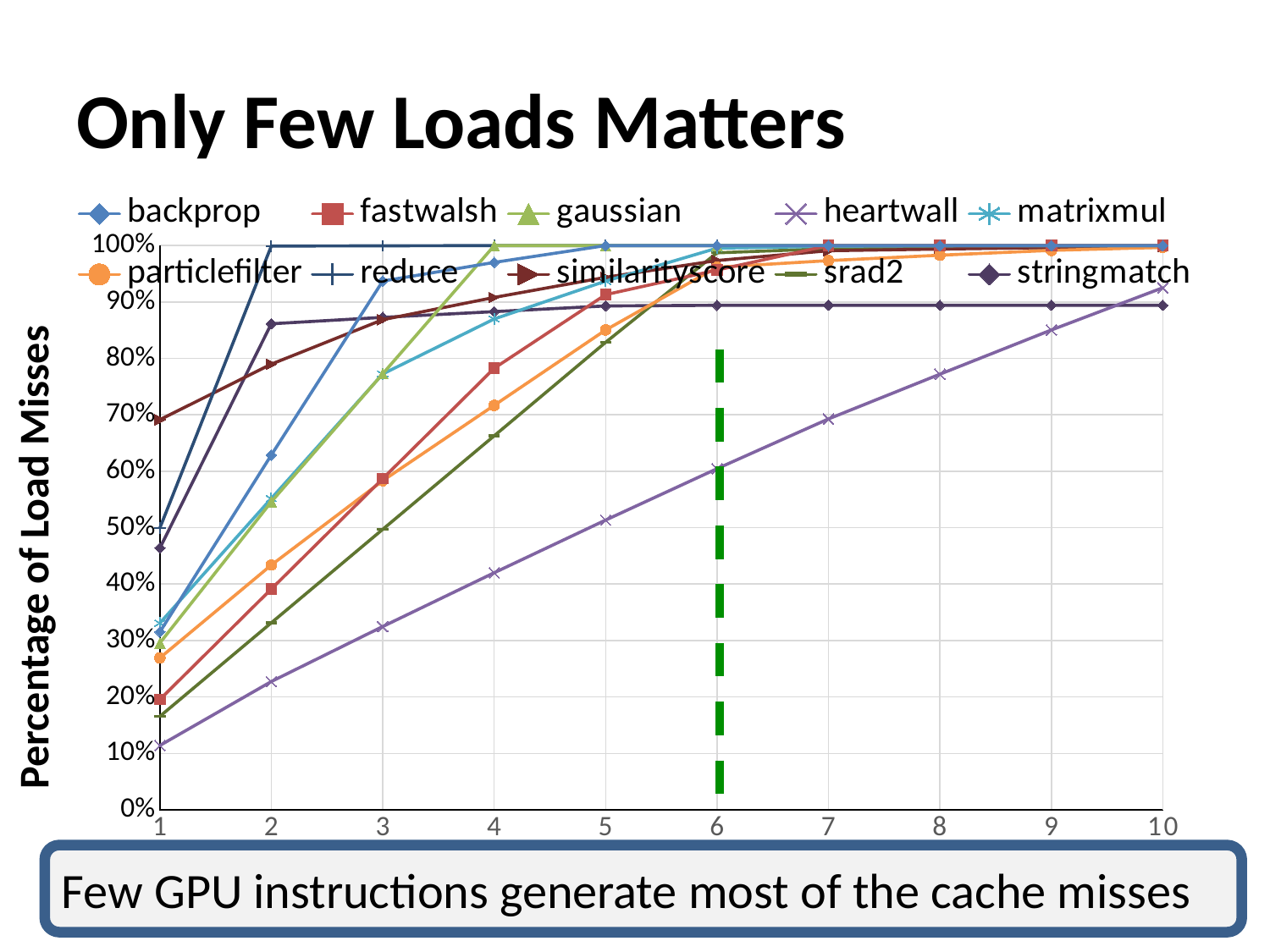
How many points are there along the x axis? 10 At x = 3, which is larger: backprop or fastwalsh? backprop Which series has the lowest value at x = 1? heartwall How many series does the legend list? 10 Is the value for similarityscore at x = 1 greater or less than 60%? greater Which series has the lowest value at x = 5? heartwall What is the title of the y axis? Percentage of Load Misses Do the values for heartwall rise or fall along the x axis? rise Which series has the highest value at x = 1? similarityscore Is the value for heartwall at x = 6 greater or less than 70%? less What kind of chart is shown on the slide? line chart Is the value for srad2 at x = 1 greater or less than 20%? less